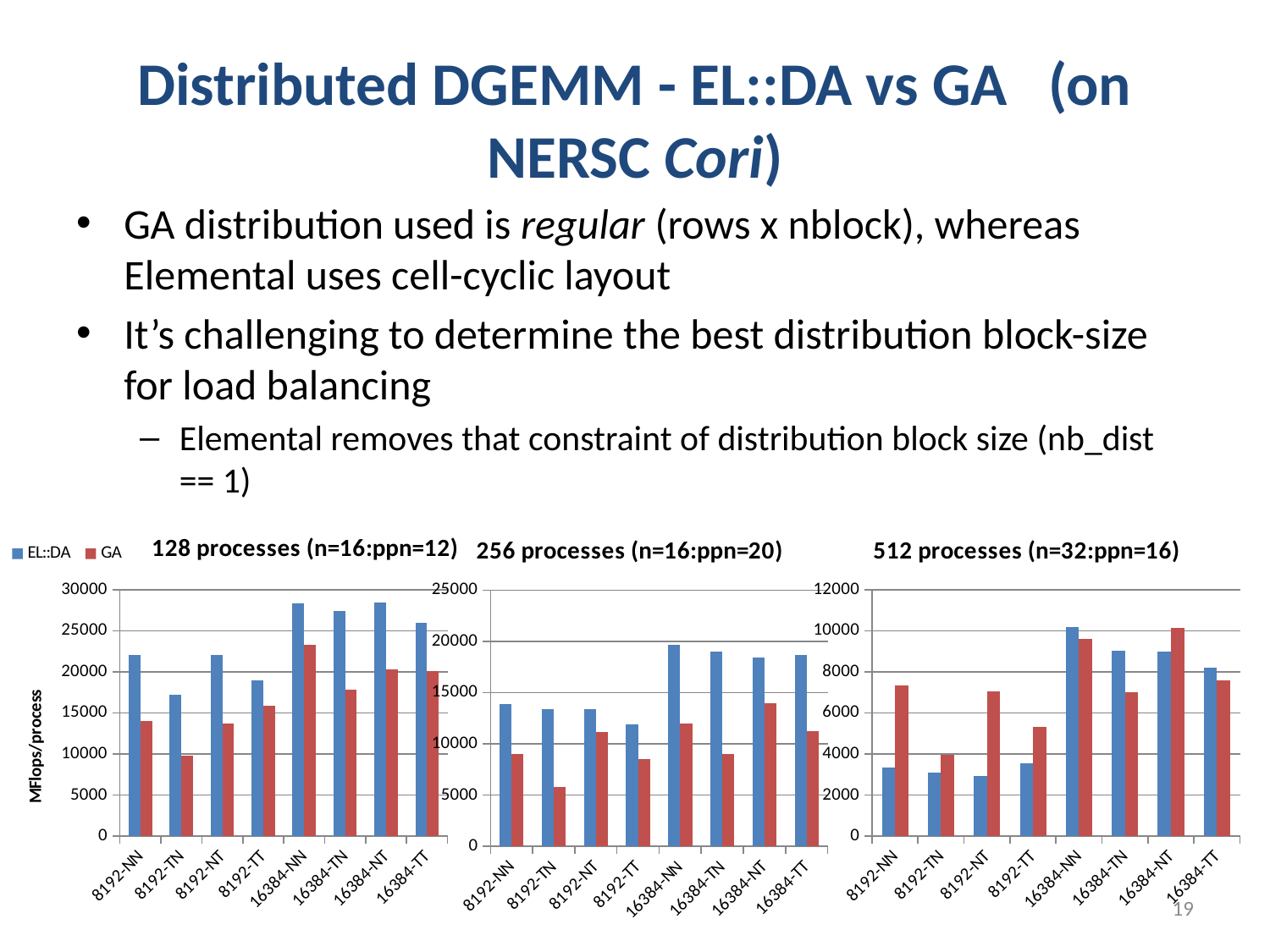
In the '512 processes (n=32:ppn=16)' chart, which category has the lowest GA value? 8192-TN In the '512 processes (n=32:ppn=16)' chart, which series has the larger value for 8192-NN, EL::DA or GA? GA In the '128 processes (n=16:ppn=12)' chart, is the EL::DA value for 8192-TN greater or less than 15000? greater In the '256 processes (n=16:ppn=20)' chart, is the GA value for 8192-TN greater or less than 10000? less How many categories are shown on the x axis of the '256 processes (n=16:ppn=20)' chart? 8 In the '256 processes (n=16:ppn=20)' chart, which series has the larger value for 16384-NN, EL::DA or GA? EL::DA What is the y-axis label shared by the charts on the slide? MFlops/process How many series does the legend list for the charts on the slide? 2 In the '256 processes (n=16:ppn=20)' chart, which category has the lowest GA value? 8192-TN What kind of chart is the '128 processes (n=16:ppn=12)' chart? bar chart